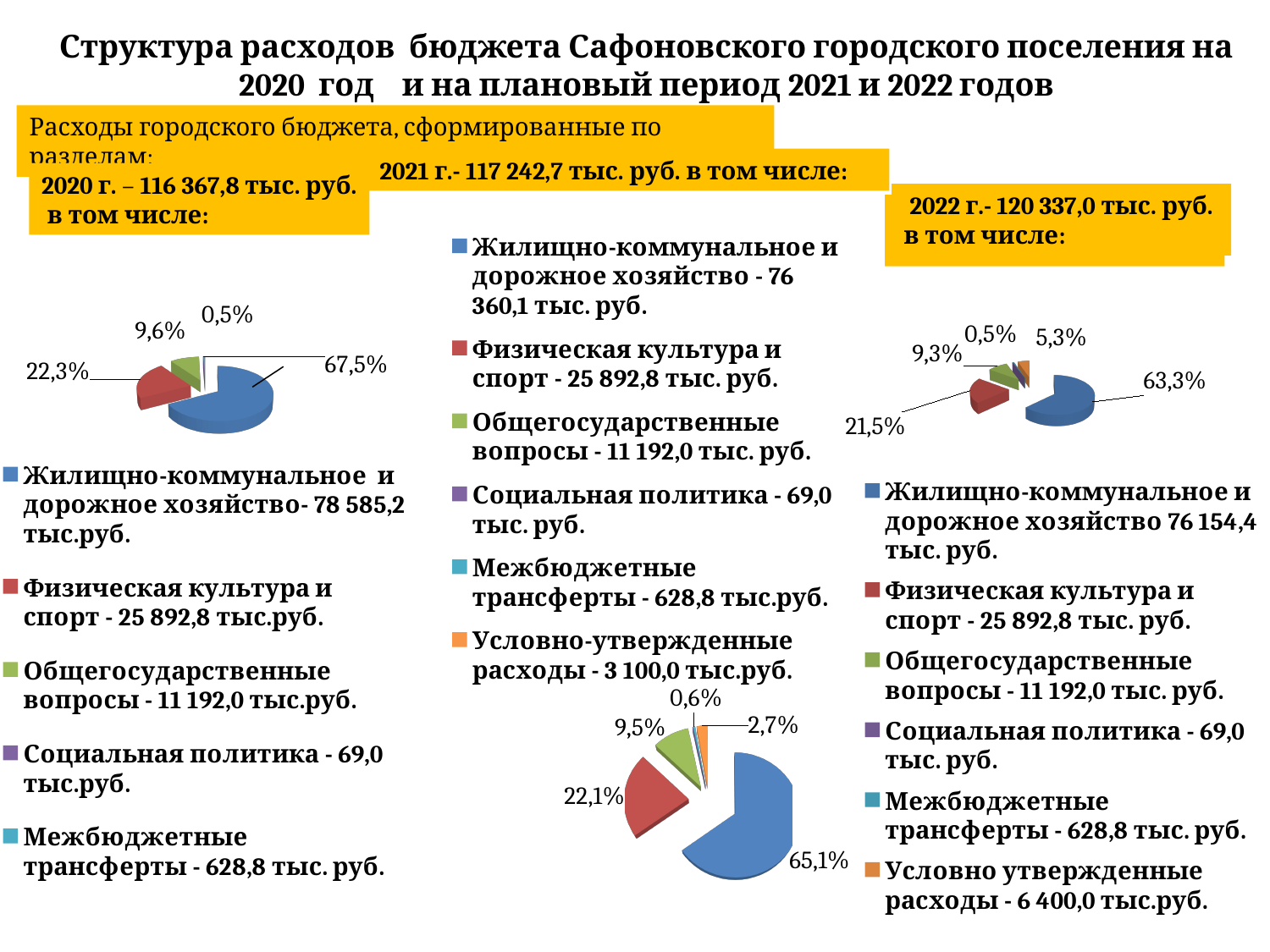
What kind of chart is used for the 2020 budget expenditure structure on the left of the slide? Pie chart In the 2021 pie chart in the middle, what is the difference between the shares for Жилищно-коммунальное и дорожное хозяйство (65,1%) and Физическая культура и спорт (22,1%)? 43 percentage points In the 2021 pie chart in the middle, which category has the largest share? Жилищно-коммунальное и дорожное хозяйство In the 2021 pie chart in the middle, what share is labelled for Условно-утвержденные расходы (the orange slice)? 2,7% In the 2020 pie chart on the left, what share is labelled for the largest slice (Жилищно-коммунальное и дорожное хозяйство)? 67,5% In the 2020 pie chart on the left, what share is labelled for Физическая культура и спорт? 22,3% How many legend entries does the 2020 pie chart on the left list? 5 According to the legend of the 2022 pie chart on the right, what amount is given for Условно утвержденные расходы? 6 400,0 тыс.руб. In the 2022 pie chart on the right, what share is labelled for Общегосударственные вопросы (the green slice)? 9,3% How many legend entries does the 2022 pie chart on the right list? 6 In the 2022 pie chart on the right, what is the smallest labelled share? 0,5% Comparing the 2020 and 2022 pie charts, which year shows a larger share for Жилищно-коммунальное и дорожное хозяйство? 2020